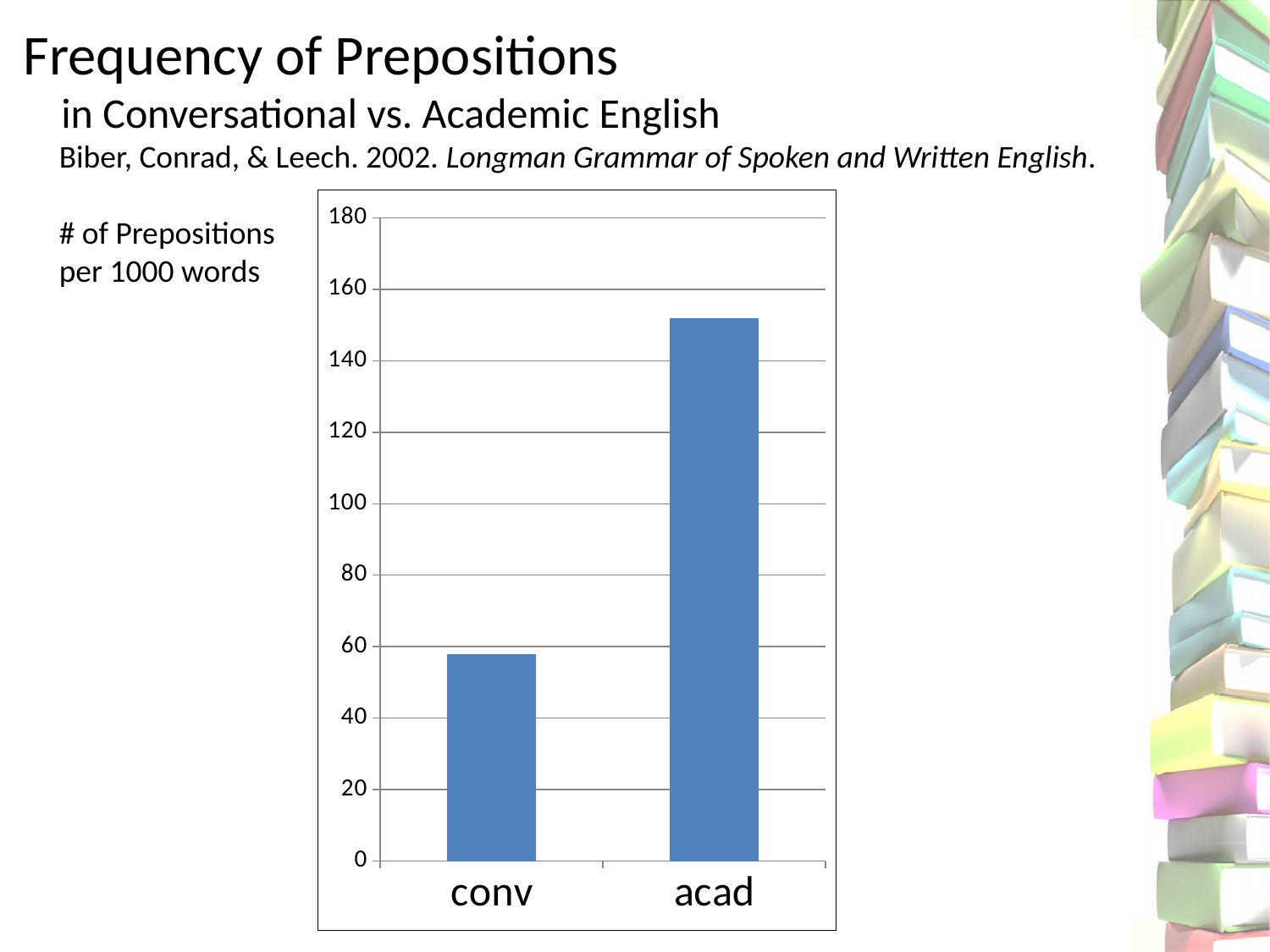
Which category has the highest bar in the chart? acad Is the value for acad greater or less than 160? less How many categories are plotted on the x axis of the chart? 2 Do the bar values rise or fall from conv to acad along the x axis? rise What kind of chart is shown on the slide? bar chart According to the text next to the chart, what does the vertical axis measure? # of Prepositions per 1000 words Is the value for acad greater or less than 140? greater What is the highest value shown on the vertical axis of the chart? 180 Is the value for conv greater or less than 60? less Which bar is taller, conv or acad? acad Which category has the lowest bar in the chart? conv